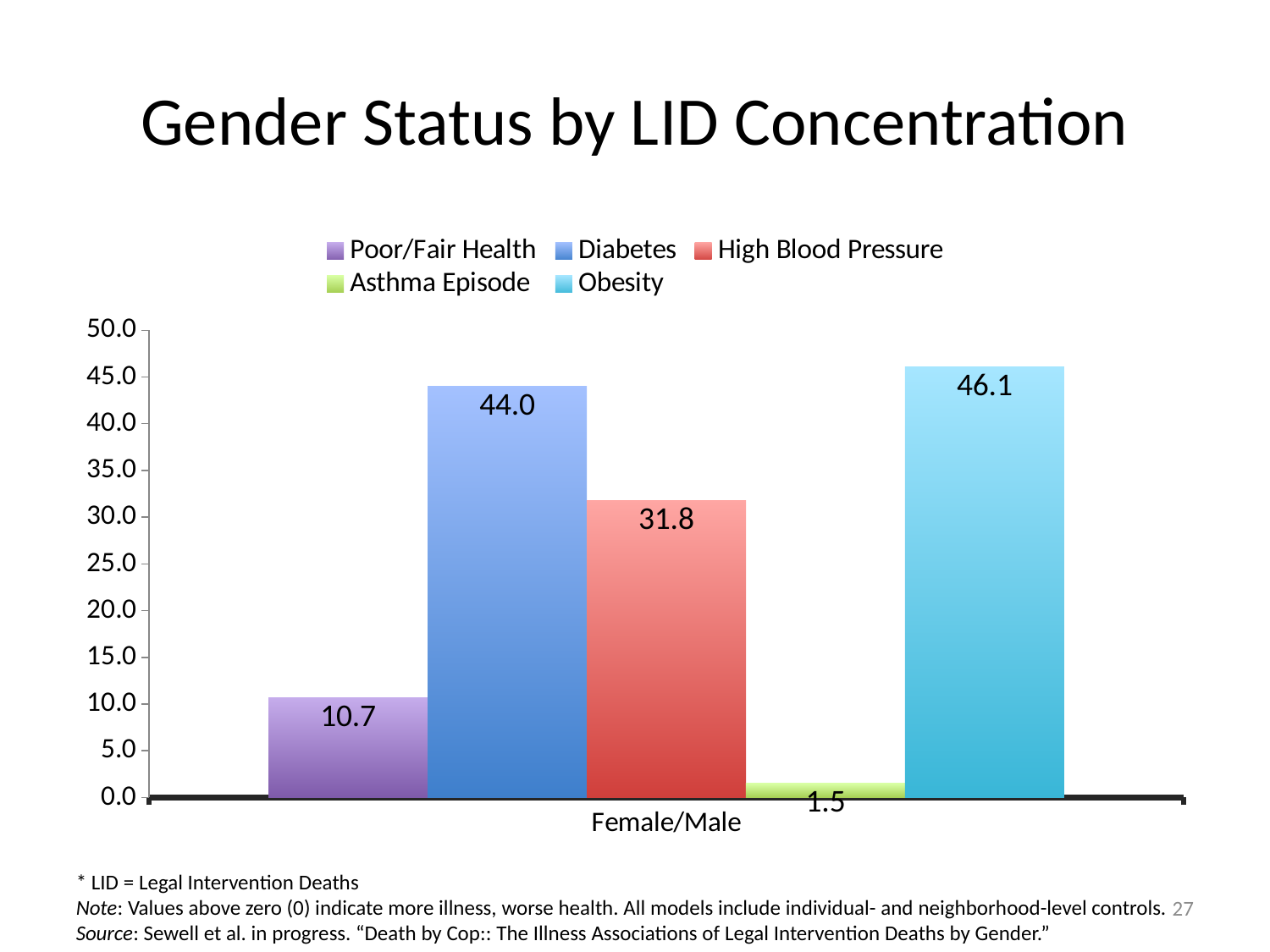
Which series has the highest value? Obesity What is the value for Asthma Episode? 1.5 What is the value for Poor/Fair Health? 10.7 Which is larger, the value for Poor/Fair Health or the value for High Blood Pressure? High Blood Pressure What is the value for Diabetes? 44.0 What is the difference between the values for Diabetes and High Blood Pressure? 12.2 What is the value for Obesity? 46.1 Is the value for High Blood Pressure greater or less than 30.0? greater Which series has the lowest value? Asthma Episode How many series does the legend list? 5 What kind of chart is shown on the slide? Bar chart What is the title of the chart? Gender Status by LID Concentration